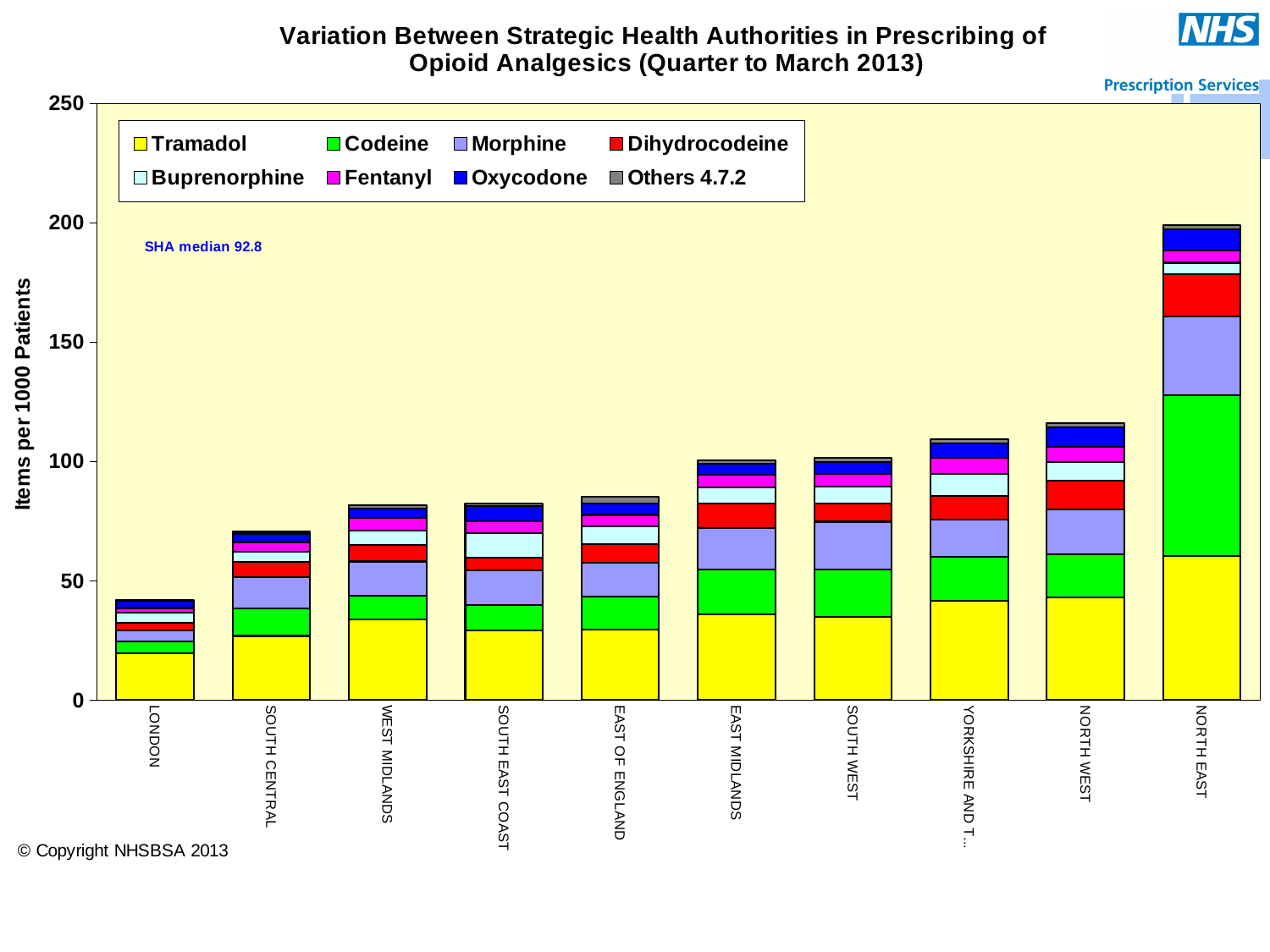
Is the total value for NORTH EAST greater or less than 150? greater Which strategic health authority has the highest total items per 1000 patients? NORTH EAST Is the total value for NORTH WEST greater or less than 100? greater Which strategic health authority has the lowest total items per 1000 patients? LONDON What kind of chart is shown on the slide? Stacked bar chart Is the total value for WEST MIDLANDS greater or less than 100? less How many series does the legend list? 8 What is the label on the y axis? Items per 1000 Patients Do the total bar heights generally rise or fall from left to right along the x axis? rise How many strategic health authorities are shown along the x axis? 10 Which has a larger total, NORTH EAST or NORTH WEST? NORTH EAST